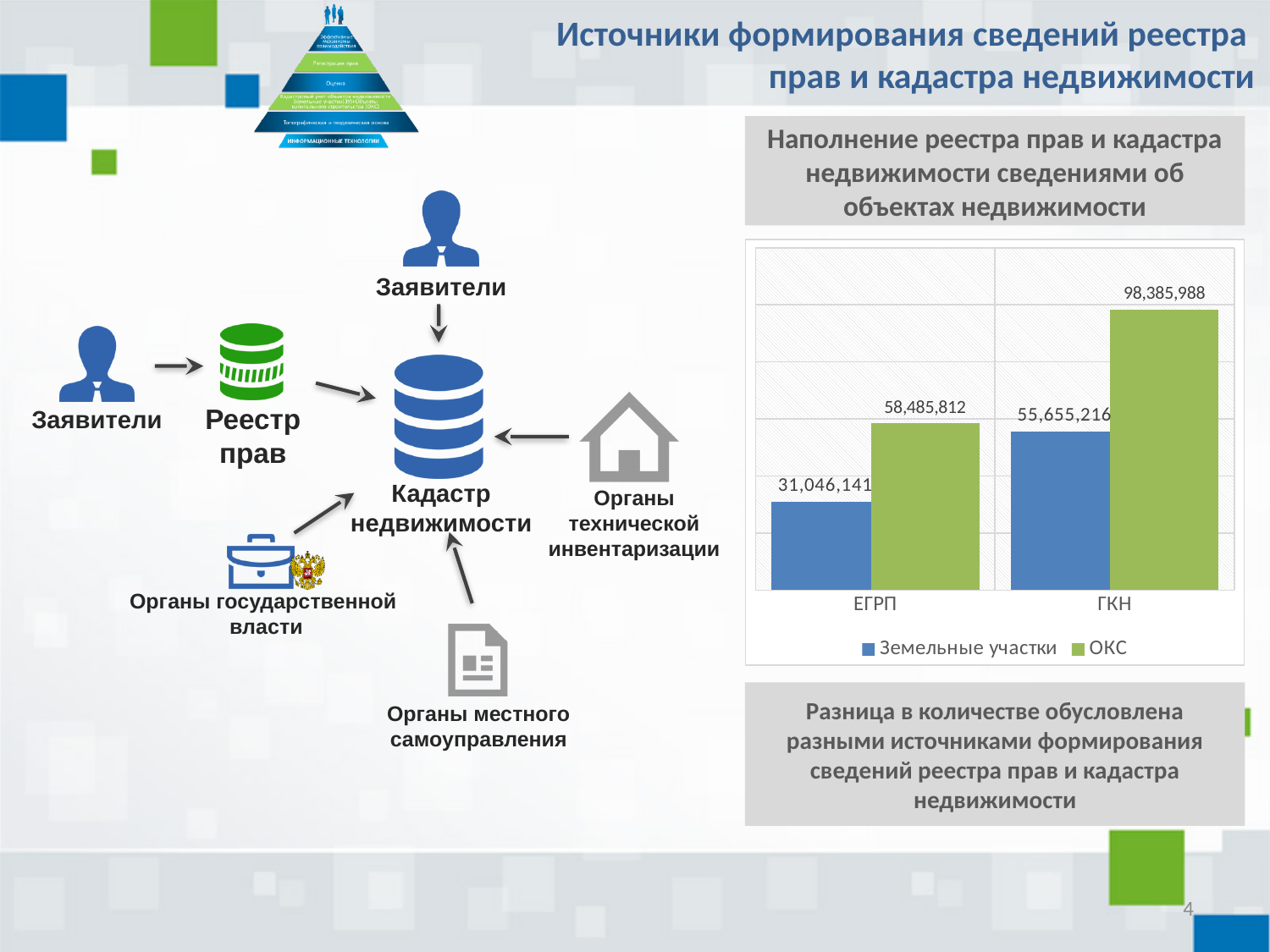
Which is larger: the Земельные участки value for ЕГРП or for ГКН? ГКН What is the value for ОКС in the ГКН category? 98,385,988 What is the difference between the ОКС and Земельные участки values in the ГКН category? 42,730,772 How many series does the chart legend list? 2 Which bar in the chart has the highest value? ОКС in ГКН How many categories are shown on the x axis of the chart? 2 What type of chart is shown on the slide? Bar chart What is the difference between the ОКС and Земельные участки values in the ЕГРП category? 27,439,671 What is the value for Земельные участки in the ГКН category? 55,655,216 Which bar in the chart has the lowest value? Земельные участки in ЕГРП What is the value for ОКС in the ЕГРП category? 58,485,812 What is the value for Земельные участки in the ЕГРП category? 31,046,141